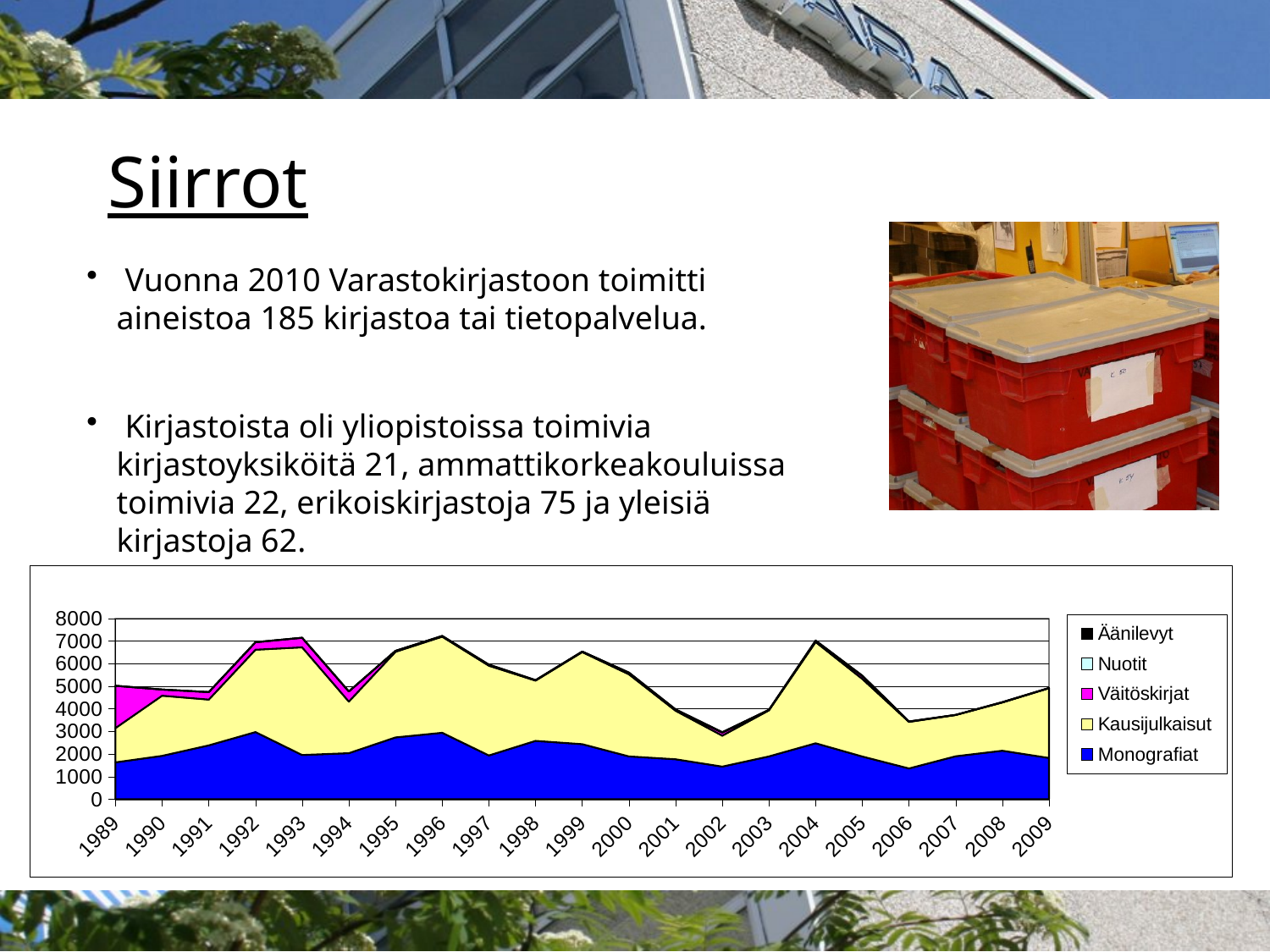
What kind of chart is shown on the slide? Stacked area chart Which series is plotted at the bottom of the stacked area chart? Monografiat Is the value for Monografiat in 1989 greater or less than 2000? less Is the value for Monografiat in 2002 greater or less than 2000? less What is the first year shown on the x axis of the chart? 1989 Is the total stacked value in 1996 greater or less than 6000? greater What is the last year shown on the x axis of the chart? 2009 How many years are shown along the x axis of the chart? 21 How many series does the chart's legend list? 5